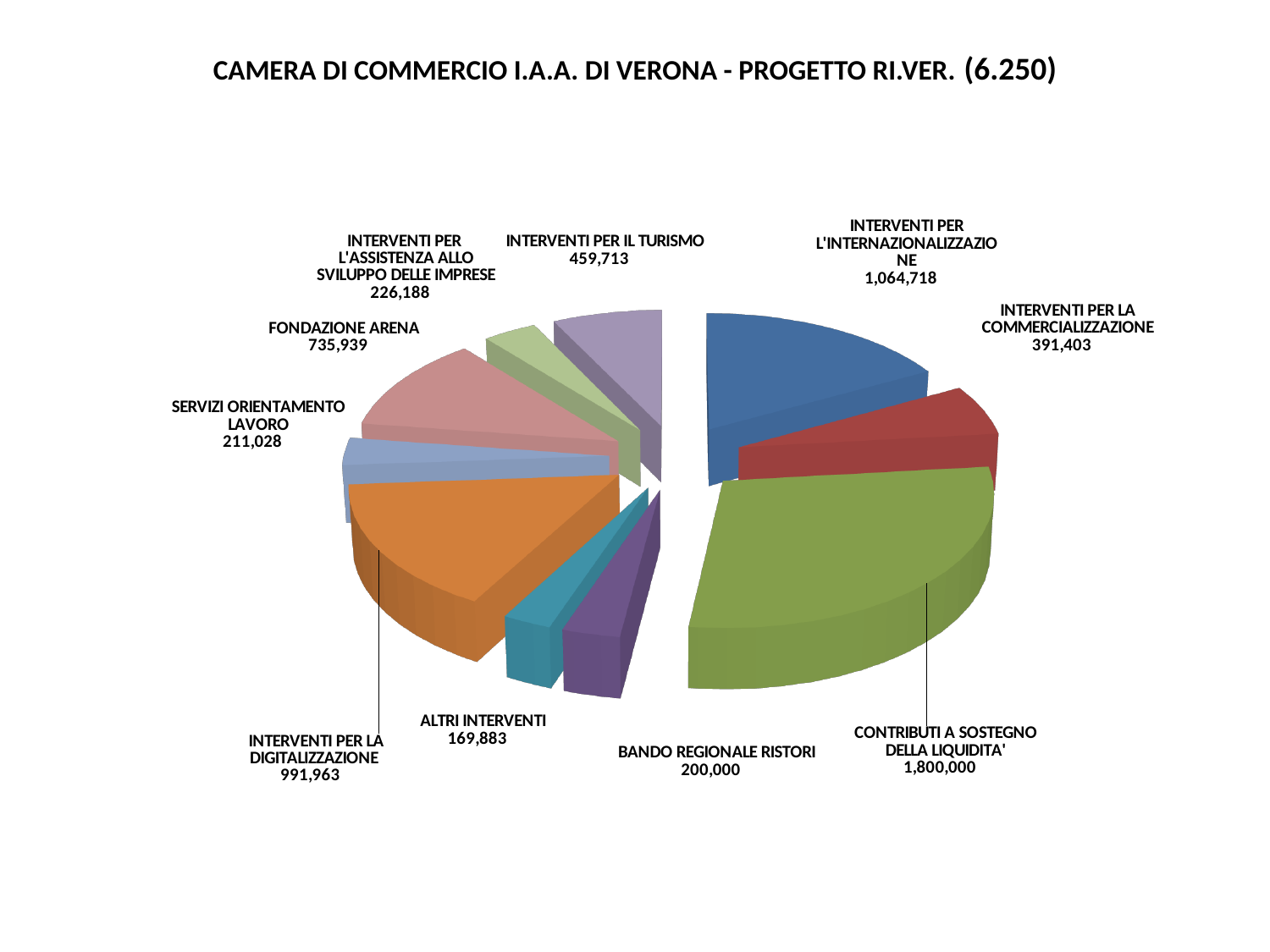
Which category has the smallest slice of the pie? ALTRI INTERVENTI What is the title of the chart? CAMERA DI COMMERCIO I.A.A. DI VERONA - PROGETTO RI.VER. (6.250) What is the value for INTERVENTI PER IL TURISMO? 459,713 What is the difference between CONTRIBUTI A SOSTEGNO DELLA LIQUIDITA' and INTERVENTI PER L'INTERNAZIONALIZZAZIONE? 735,282 Which category has the largest slice of the pie? CONTRIBUTI A SOSTEGNO DELLA LIQUIDITA' What is the value for SERVIZI ORIENTAMENTO LAVORO? 211,028 What is the value for FONDAZIONE ARENA? 735,939 Which is larger, INTERVENTI PER IL TURISMO or INTERVENTI PER LA COMMERCIALIZZAZIONE? INTERVENTI PER IL TURISMO How many categories are shown in the pie chart? 10 What is the value for CONTRIBUTI A SOSTEGNO DELLA LIQUIDITA'? 1,800,000 What is the difference between INTERVENTI PER LA DIGITALIZZAZIONE and FONDAZIONE ARENA? 256,024 What kind of chart is shown on the slide? Pie chart